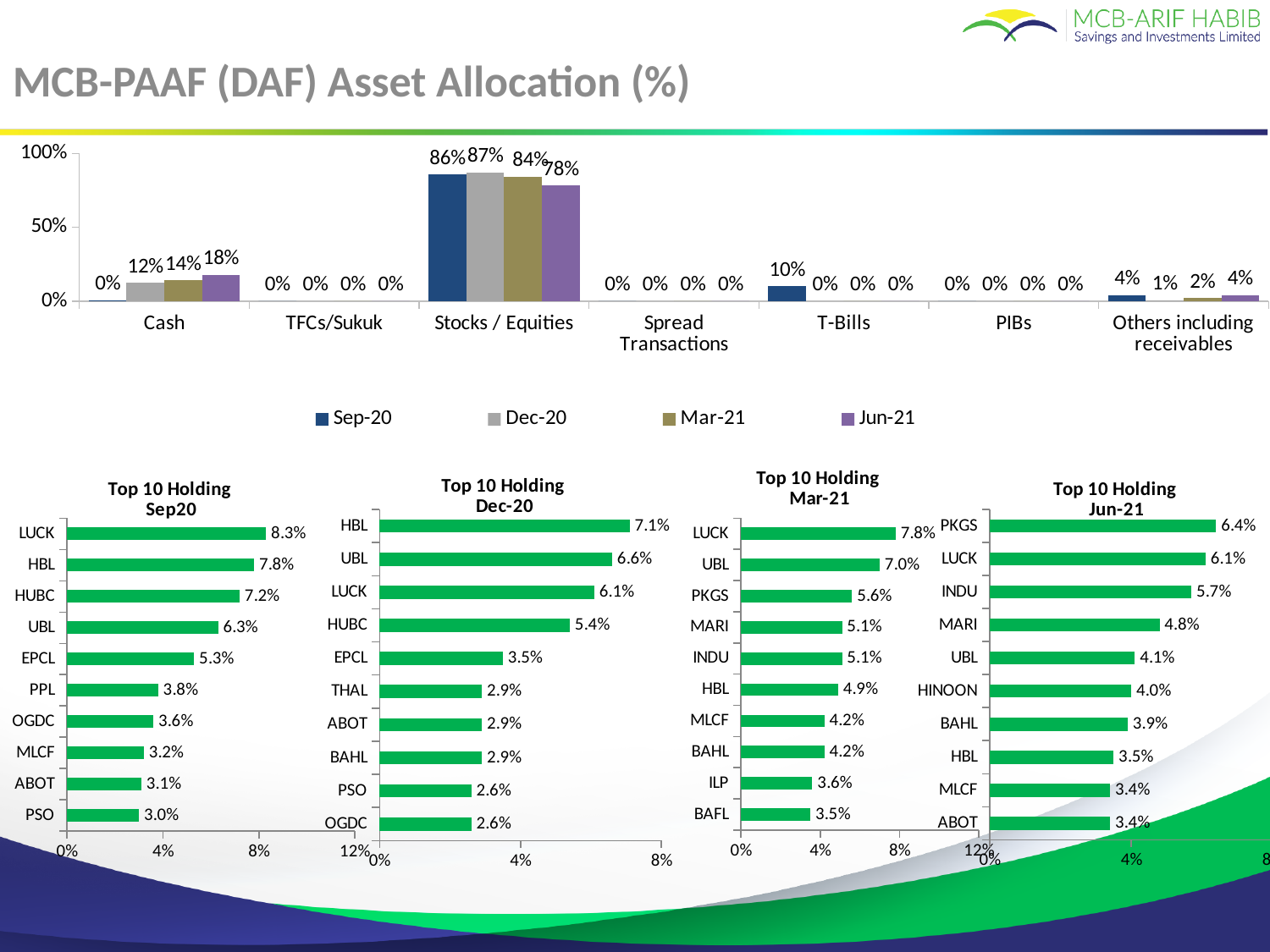
In the Top 10 Holding Jun-21 chart, what is the value for INDU? 5.7% In the asset allocation chart at the top of the slide, how many series does the legend list? 4 In the asset allocation chart at the top of the slide, does the Stocks / Equities allocation rise or fall from Dec-20 through Jun-21? fall In the asset allocation chart at the top of the slide, what is the Sep-20 value for T-Bills? 10% What kind of chart is the Top 10 Holding Jun-21 chart? bar chart In the Top 10 Holding Mar-21 chart, what is the difference between the values for UBL and BAFL? 3.5% In the Top 10 Holding Mar-21 chart, which is larger, the value for LUCK or the value for PKGS? LUCK In the asset allocation chart at the top of the slide, what is the Jun-21 value for Cash? 18% In the Top 10 Holding Dec-20 chart, what is the value for HBL? 7.1% In the Top 10 Holding Sep20 chart, which holding has the highest value? LUCK In the asset allocation chart at the top of the slide, by how many percentage points did Stocks / Equities fall from Dec-20 to Jun-21? 9% In the Top 10 Holding Sep20 chart, what is the value for EPCL? 5.3%